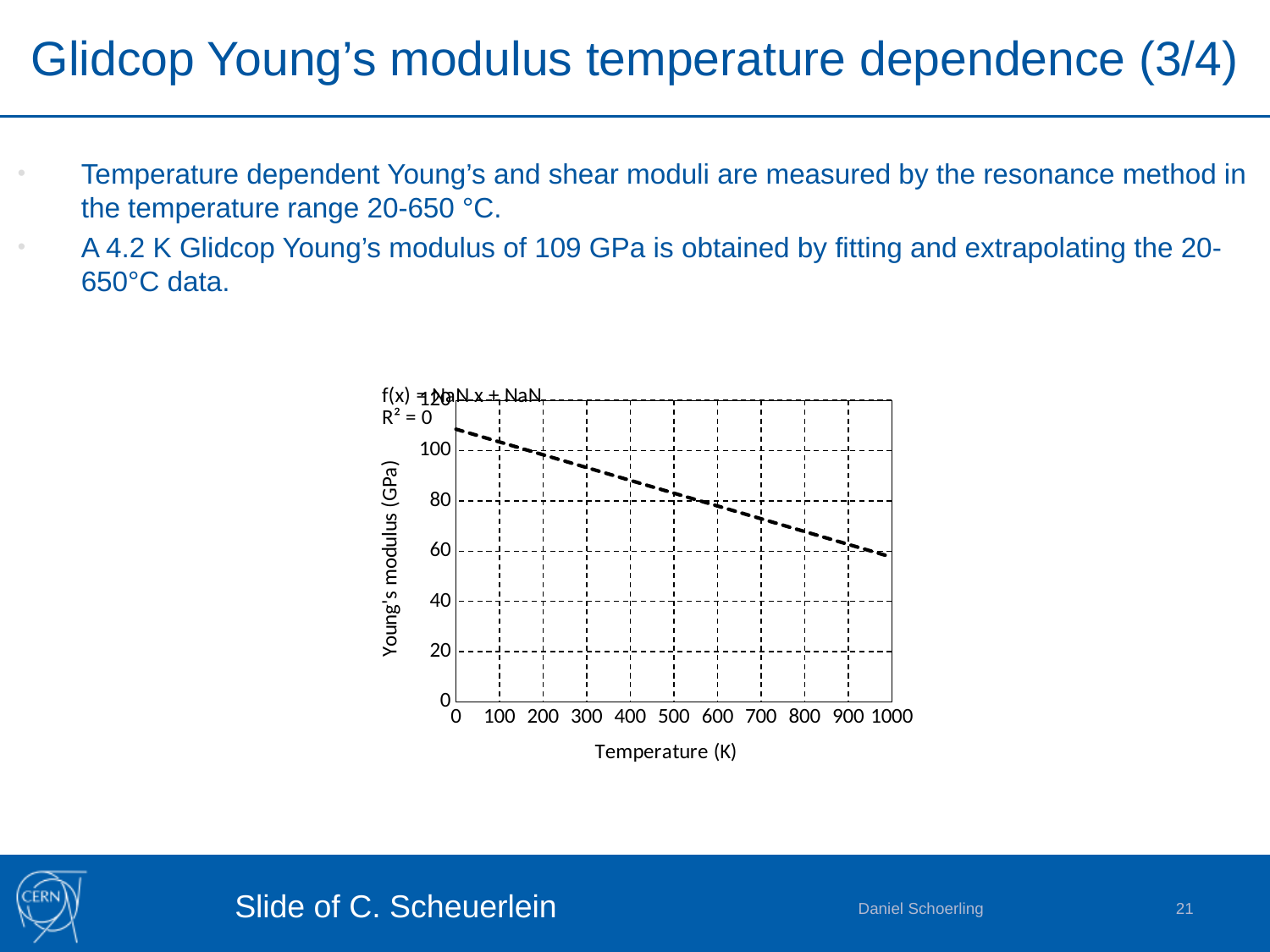
What is the label of the y axis of the chart? Young's modulus (GPa) Is the Young's modulus at 800 K greater or less than 80 GPa? less What kind of chart is shown on the slide? line chart Does Young's modulus rise or fall as temperature increases along the x axis? fall Is the Young's modulus at 800 K greater or less than 60 GPa? greater What is the label of the x axis of the chart? Temperature (K) Which temperature has the higher Young's modulus on the chart, 100 K or 900 K? 100 K How many data series are plotted on the chart? 1 Is the Young's modulus at 500 K greater or less than 80 GPa? greater